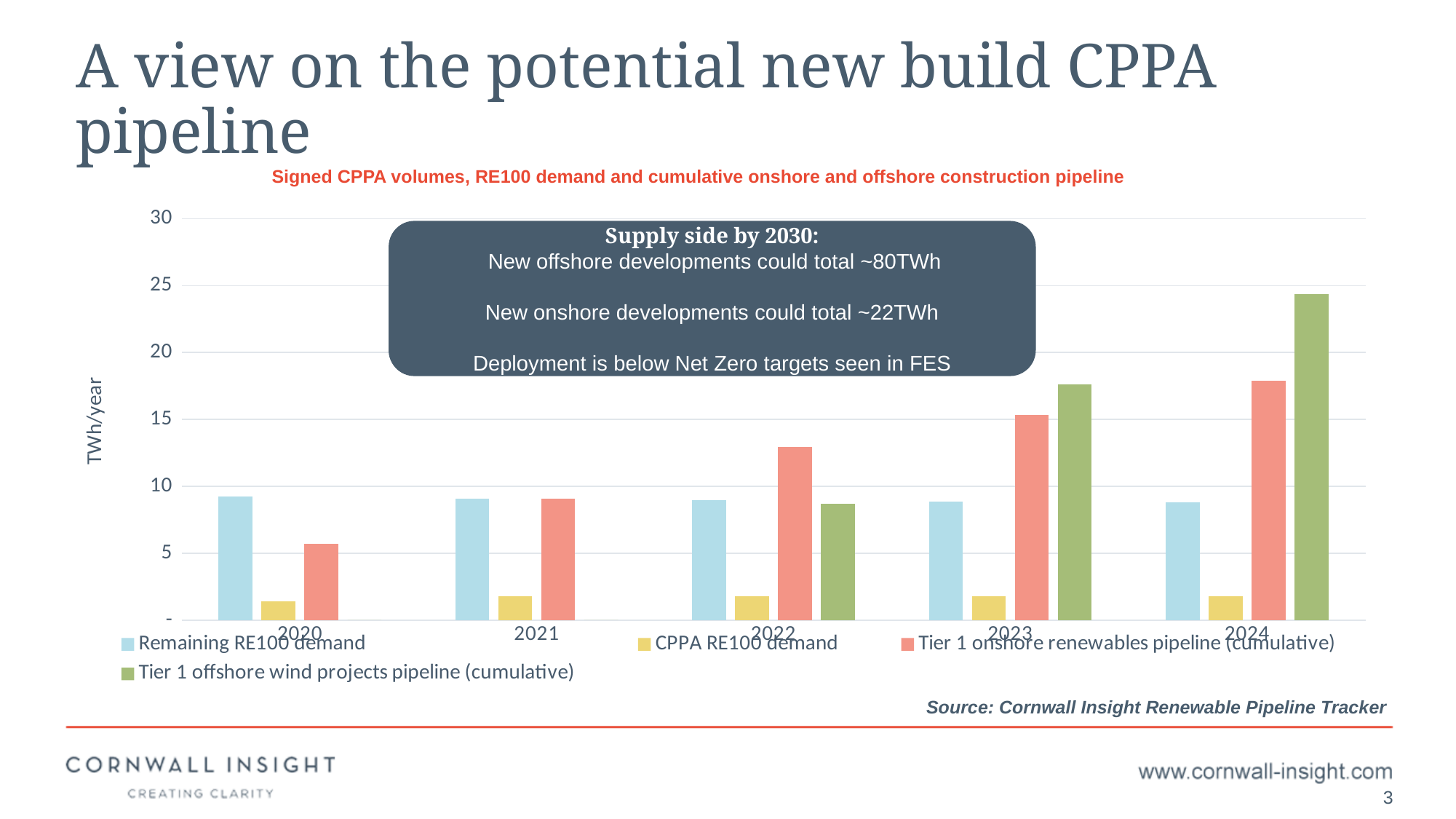
In which year is the Tier 1 onshore renewables pipeline (cumulative) highest? 2024 Is the value for Tier 1 onshore renewables pipeline (cumulative) in 2022 greater or less than 10? greater In 2024, which is larger: the Tier 1 offshore wind projects pipeline or the Tier 1 onshore renewables pipeline? Tier 1 offshore wind projects pipeline (cumulative) How many years are shown on the x axis? 5 Is the value for CPPA RE100 demand in 2021 greater or less than 5? less How many series does the legend list? 4 Is the value for Tier 1 offshore wind projects pipeline (cumulative) in 2024 greater or less than 20? greater What kind of chart is shown on the slide? Bar chart Does the Tier 1 onshore renewables pipeline (cumulative) rise or fall from 2020 to 2024? rise In 2020, which is larger: Remaining RE100 demand or the Tier 1 onshore renewables pipeline? Remaining RE100 demand In which year is the Tier 1 onshore renewables pipeline (cumulative) lowest? 2020 What is the label on the y axis of the chart? TWh/year